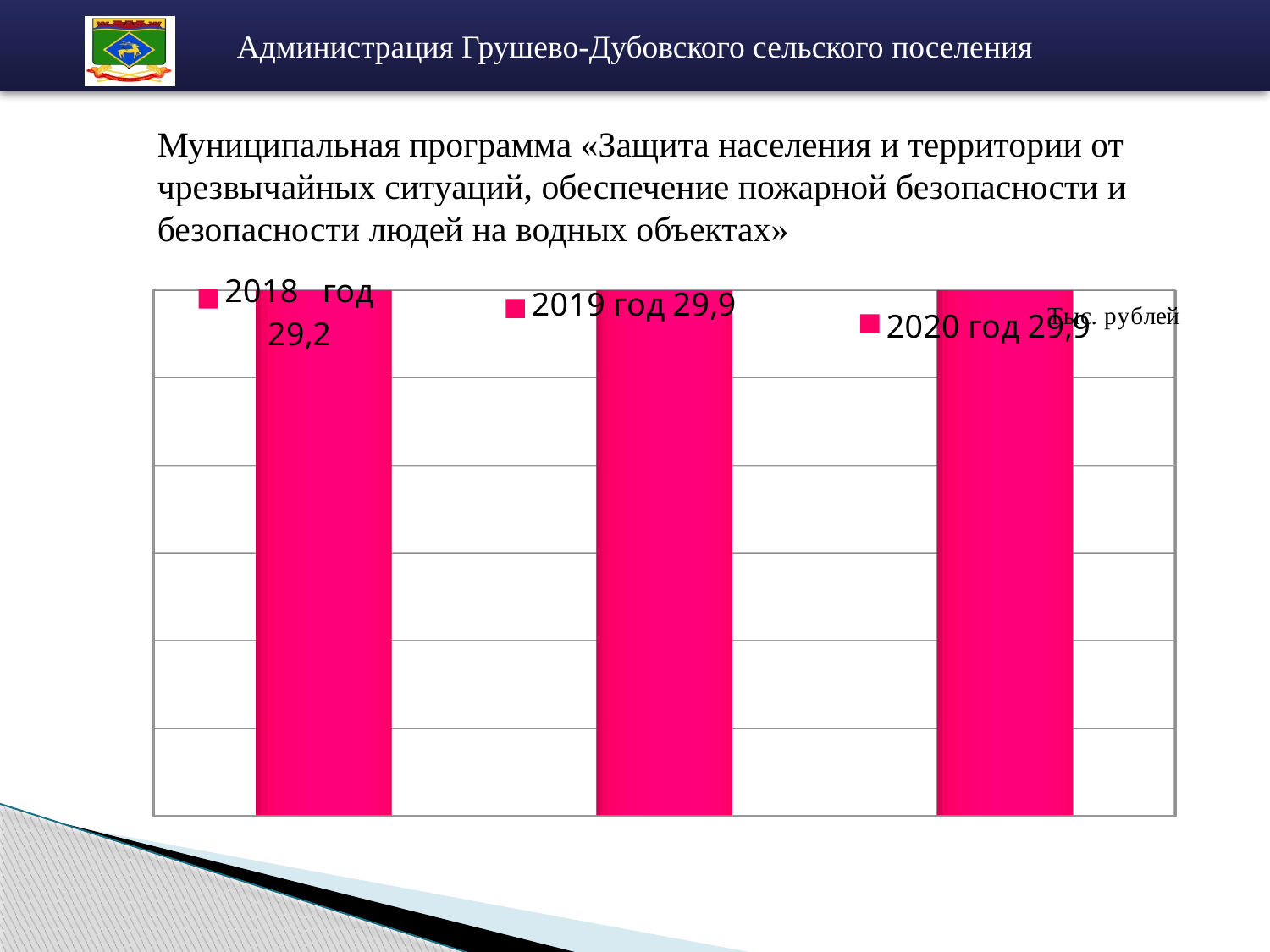
Does the value rise or fall from 2018 год to 2019 год? Rise What is the value for 2020 год? 29,9 What kind of chart is shown on the slide? Bar chart Which year has the lowest value? 2018 год What is the difference between the values for 2019 год and 2018 год? 0,7 How many bars are shown in the chart? 3 What is the value for 2019 год? 29,9 What is the value for 2018 год? 29,2 Are the values for 2019 год and 2020 год equal? Yes What unit is indicated on the chart? Тыс. рублей Which is larger, the value for 2018 год or the value for 2019 год? 2019 год